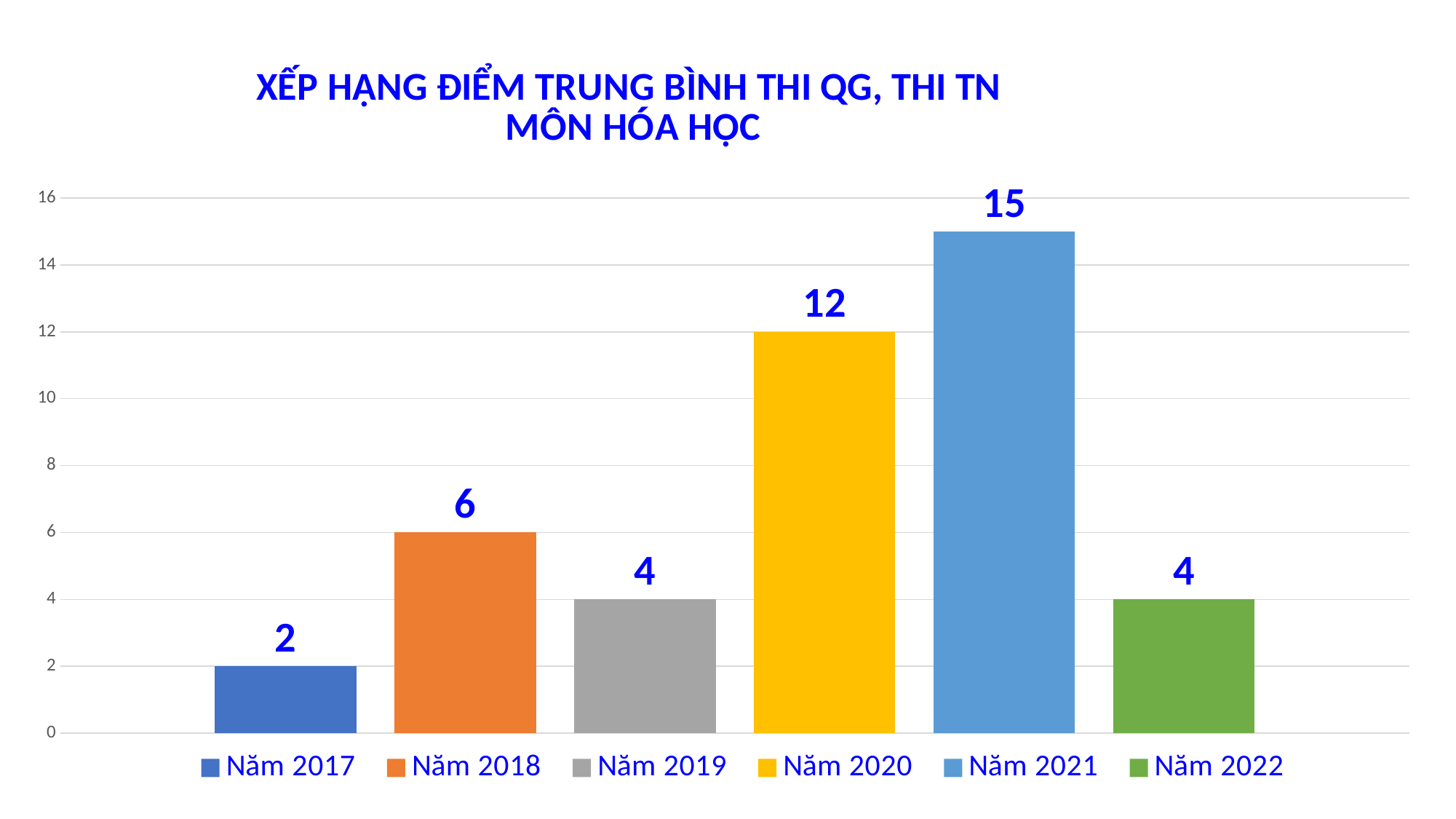
What colour is the bar for Năm 2020? Yellow How many entries does the legend list? 6 What is the difference between the values for Năm 2021 and Năm 2018? 9 What is the value for Năm 2020? 12 Which year has the highest value? Năm 2021 What is the value for Năm 2022? 4 What is the value for Năm 2017? 2 How many bars are plotted in the chart? 6 What kind of chart is shown on the slide? Bar chart Which year has the lowest value? Năm 2017 Which is larger, the value for Năm 2018 or the value for Năm 2019? Năm 2018 Is the value for Năm 2021 greater or less than 14? greater